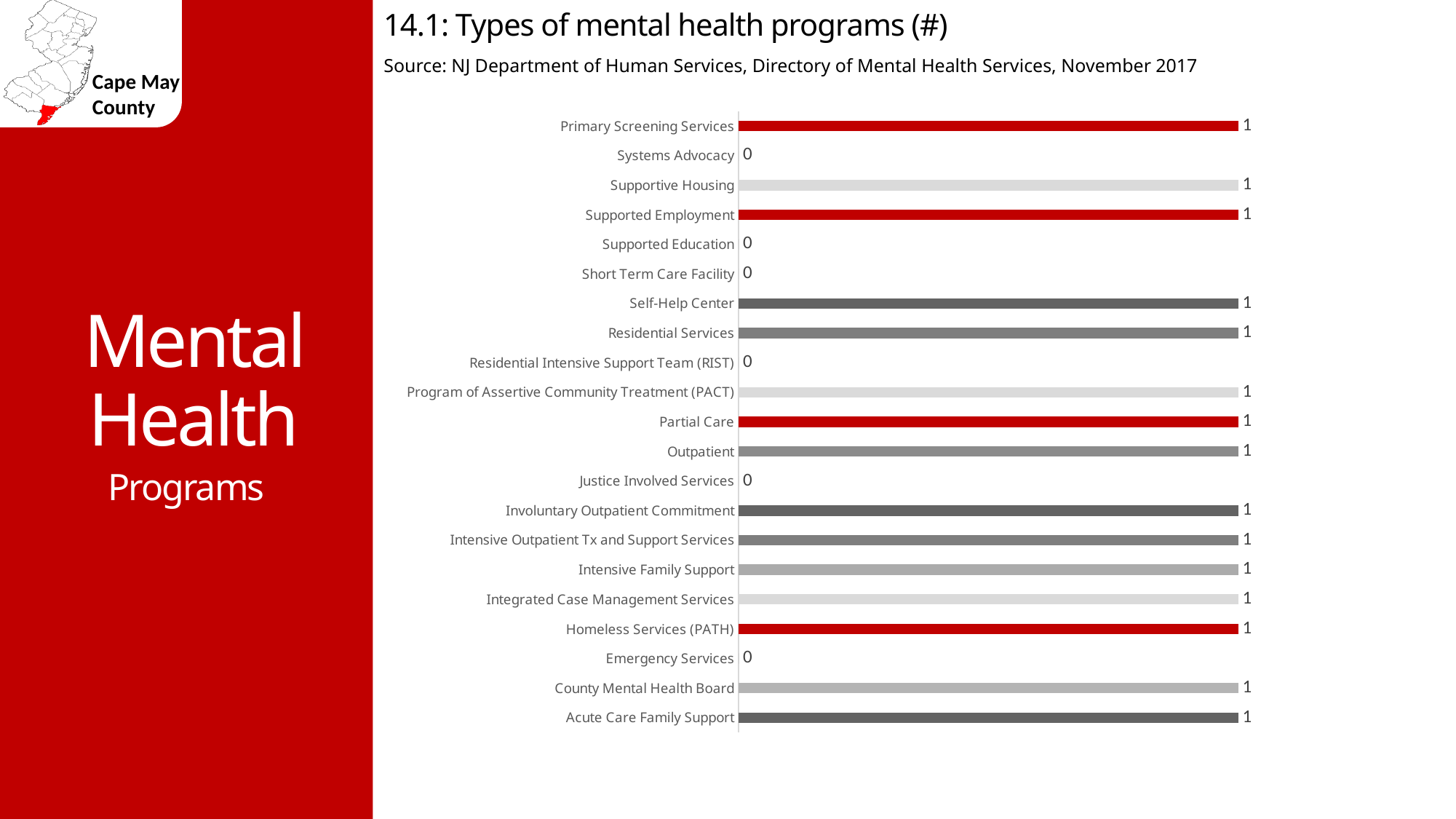
What is the value for Homeless Services (PATH)? 1 What is the difference between the value for Outpatient and the value for Short Term Care Facility? 1 What is the value for Primary Screening Services? 1 Which is larger, the value for Supported Education or the value for Supported Employment? Supported Employment What kind of chart is shown on the slide? Bar chart What is the value for Emergency Services? 0 What is the value for Systems Advocacy? 0 Which is larger, the value for Partial Care or the value for Justice Involved Services? Partial Care What is the value for Residential Intensive Support Team (RIST)? 0 How many program types are listed on the chart? 21 What is the title of the chart? 14.1: Types of mental health programs (#) How many program types have a value of 0? 6